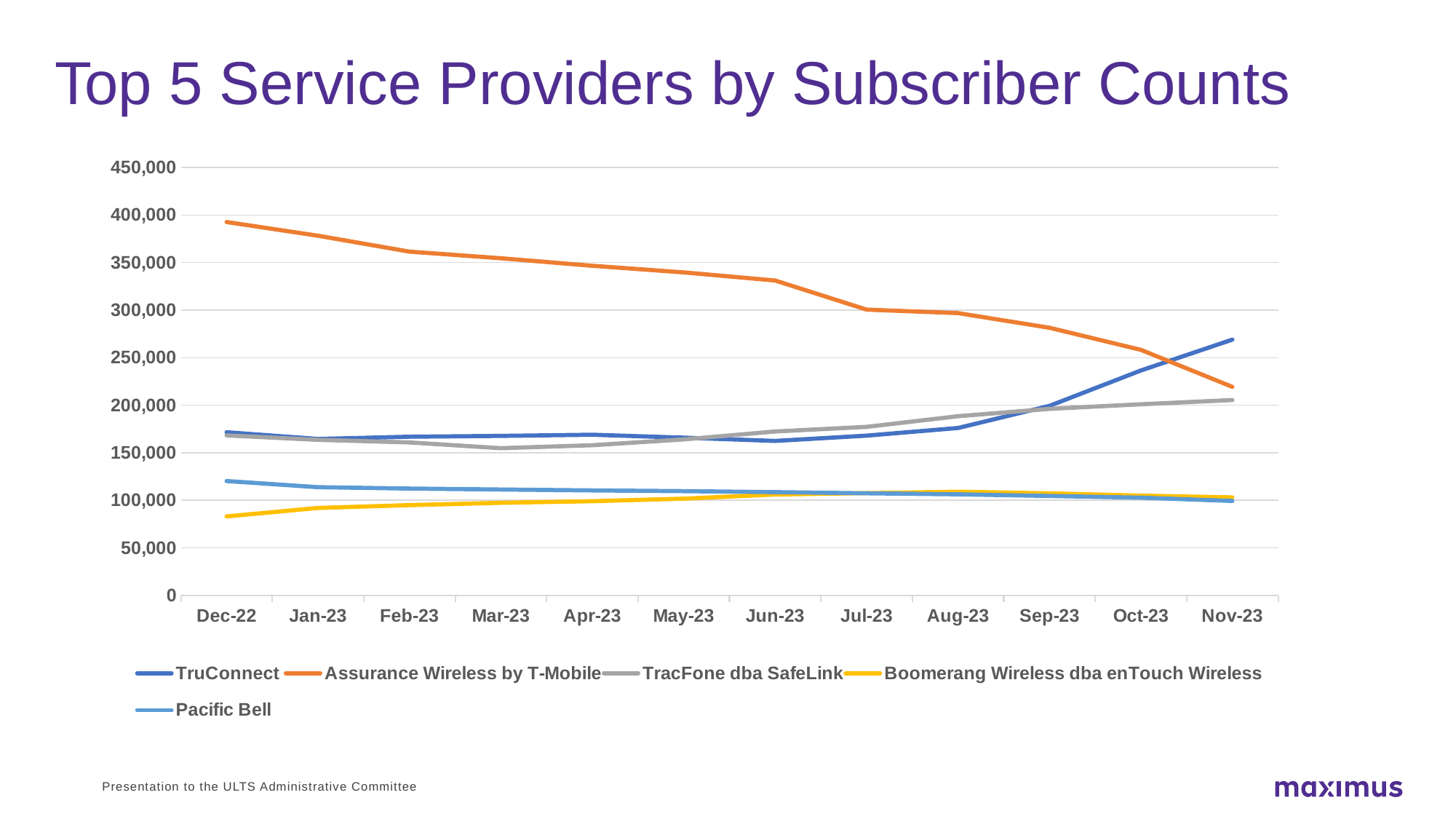
Does the TruConnect line rise or fall from Dec-22 to Nov-23? rise Which service provider has the lowest subscriber count in Dec-22? Boomerang Wireless dba enTouch Wireless Does the Assurance Wireless by T-Mobile line rise or fall from Dec-22 to Nov-23? fall What kind of chart is shown on the slide? line chart Is the value for TracFone dba SafeLink in Nov-23 greater or less than 150,000? greater Which service provider has the highest subscriber count in Dec-22? Assurance Wireless by T-Mobile What is the title of the chart? Top 5 Service Providers by Subscriber Counts How many months are shown along the x axis? 12 Is the value for Assurance Wireless by T-Mobile in Dec-22 greater or less than 350,000? greater Which service provider has the highest subscriber count in Nov-23? TruConnect Is the value for Boomerang Wireless dba enTouch Wireless in Dec-22 greater or less than 100,000? less How many series does the legend list? 5